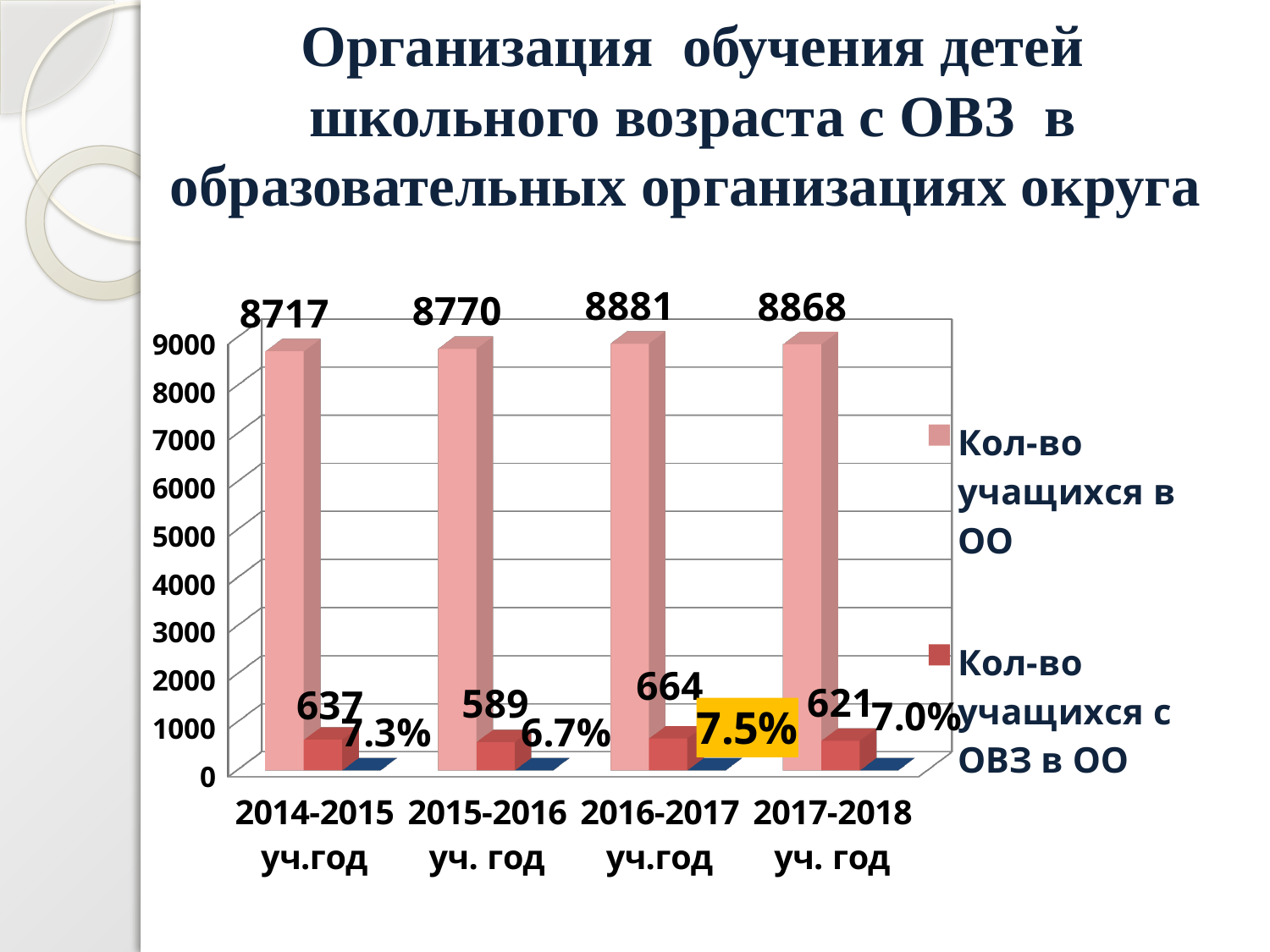
What kind of chart is shown on the slide? bar chart In which school year is "Кол-во учащихся с ОВЗ в ОО" the lowest? 2015-2016 уч. год How many series does the legend list? 2 Which is larger: "Кол-во учащихся с ОВЗ в ОО" in 2014-2015 уч.год or in 2017-2018 уч. год? 2014-2015 уч.год In which school year is "Кол-во учащихся в ОО" the highest? 2016-2017 уч.год Is the value of "Кол-во учащихся с ОВЗ в ОО" for 2015-2016 уч. год greater or less than 1000? less What is the difference between "Кол-во учащихся в ОО" in 2016-2017 уч.год and in 2014-2015 уч.год? 164 How many school years are shown on the x axis? 4 What is the value of "Кол-во учащихся с ОВЗ в ОО" for 2016-2017 уч.год? 664 What is the value of "Кол-во учащихся в ОО" for 2014-2015 уч.год? 8717 What percentage is shown for 2017-2018 уч. год? 7.0% What is the difference between "Кол-во учащихся с ОВЗ в ОО" in 2016-2017 уч.год and in 2015-2016 уч. год? 75